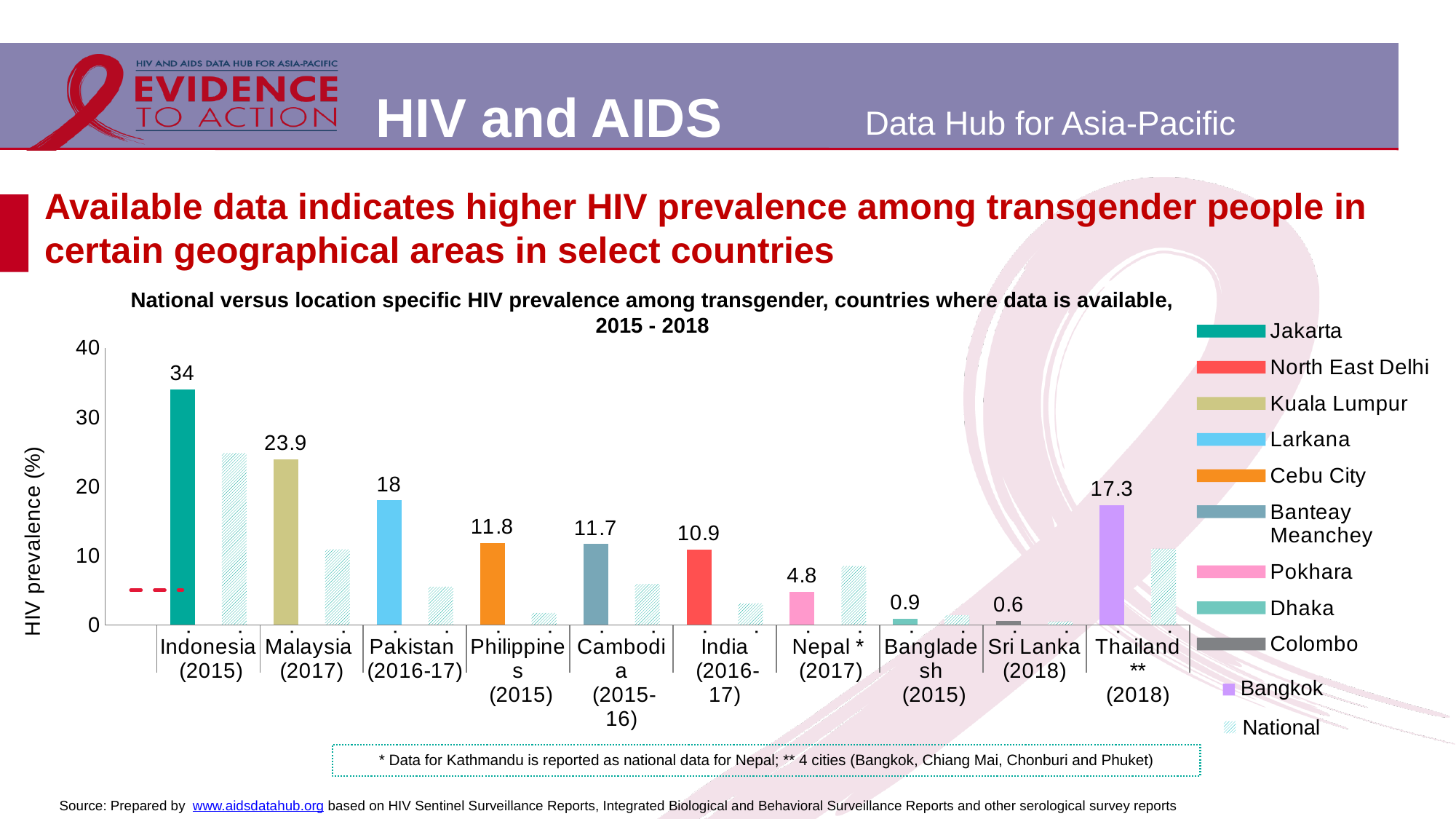
Is the National value for Indonesia (2015) greater or less than 20? greater Which location has the lowest labelled HIV prevalence value on the chart? Colombo What is the HIV prevalence value shown for Pokhara (Nepal, 2017)? 4.8 What type of chart is shown on the slide? Bar chart How many countries are shown along the x axis of the chart? 10 Is the National value for Pakistan (2016-17) greater or less than 10? less What is the difference between the labelled values for Jakarta and Kuala Lumpur? 10.1 How many entries does the chart legend list? 11 What is the HIV prevalence value shown for Bangkok (Thailand, 2018)? 17.3 What is the HIV prevalence value shown for Jakarta (Indonesia, 2015)? 34 Which location has the highest labelled HIV prevalence value on the chart? Jakarta Which has a higher labelled value: North East Delhi or Pokhara? North East Delhi